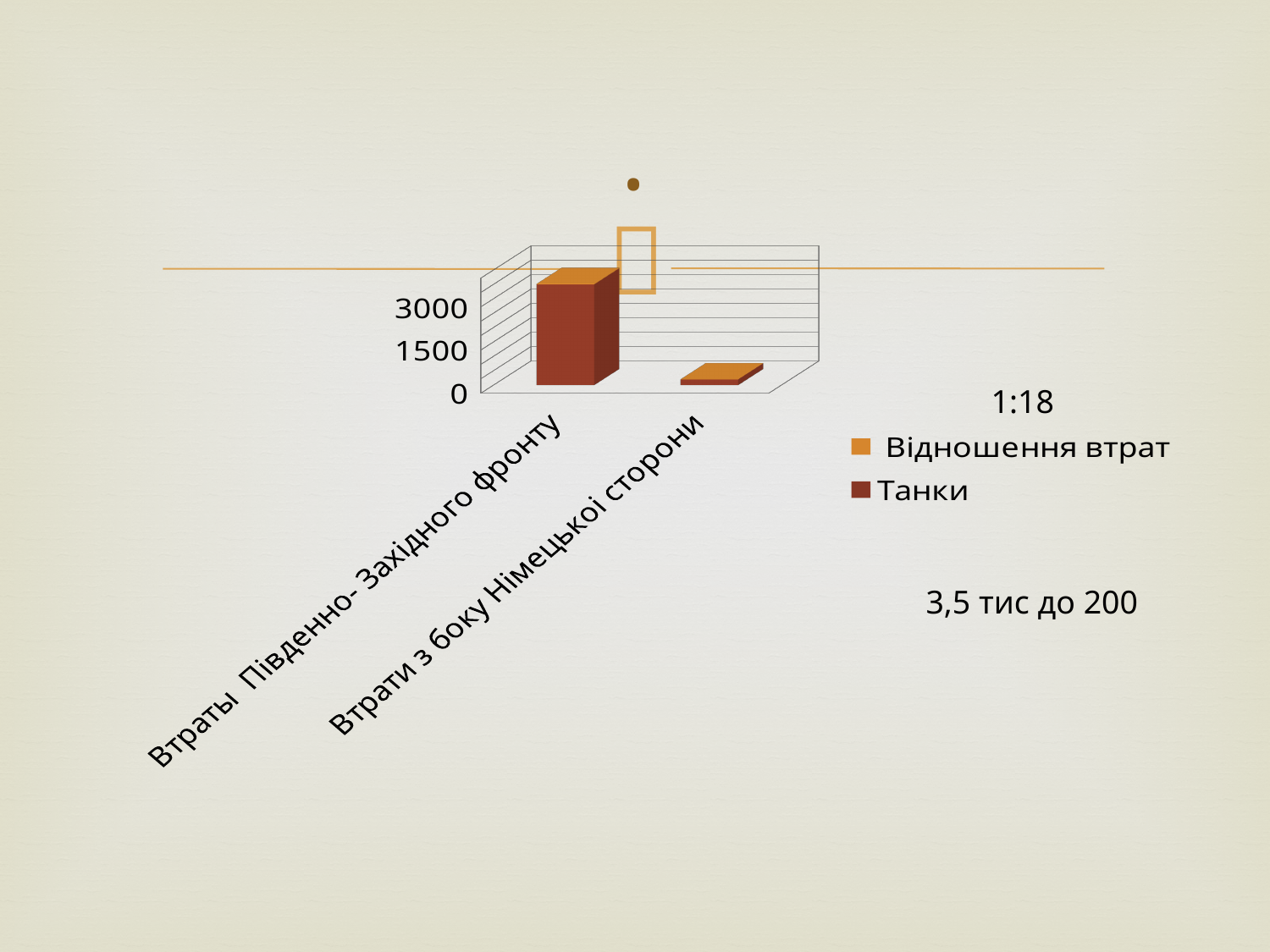
How many categories are shown on the x axis of the chart? 2 What kind of chart is shown on the slide? bar chart What are the legend entries of the chart? Відношення втрат, Танки Which category has the highest bar in the chart? Втрати Південно-Західного фронту Which is larger: the bar for Втрати Південно-Західного фронту or the bar for Втрати з боку Німецької сторони? Втрати Південно-Західного фронту How many series does the chart legend list? 2 What is the highest tick label shown on the vertical axis of the chart? 3000 Which category has the lowest bar in the chart? Втрати з боку Німецької сторони Is the value for Втрати Південно-Західного фронту greater or less than 3000? greater Is the value for Втрати Південно-Західного фронту greater or less than 1500? greater Is the value for Втрати з боку Німецької сторони greater or less than 1500? less